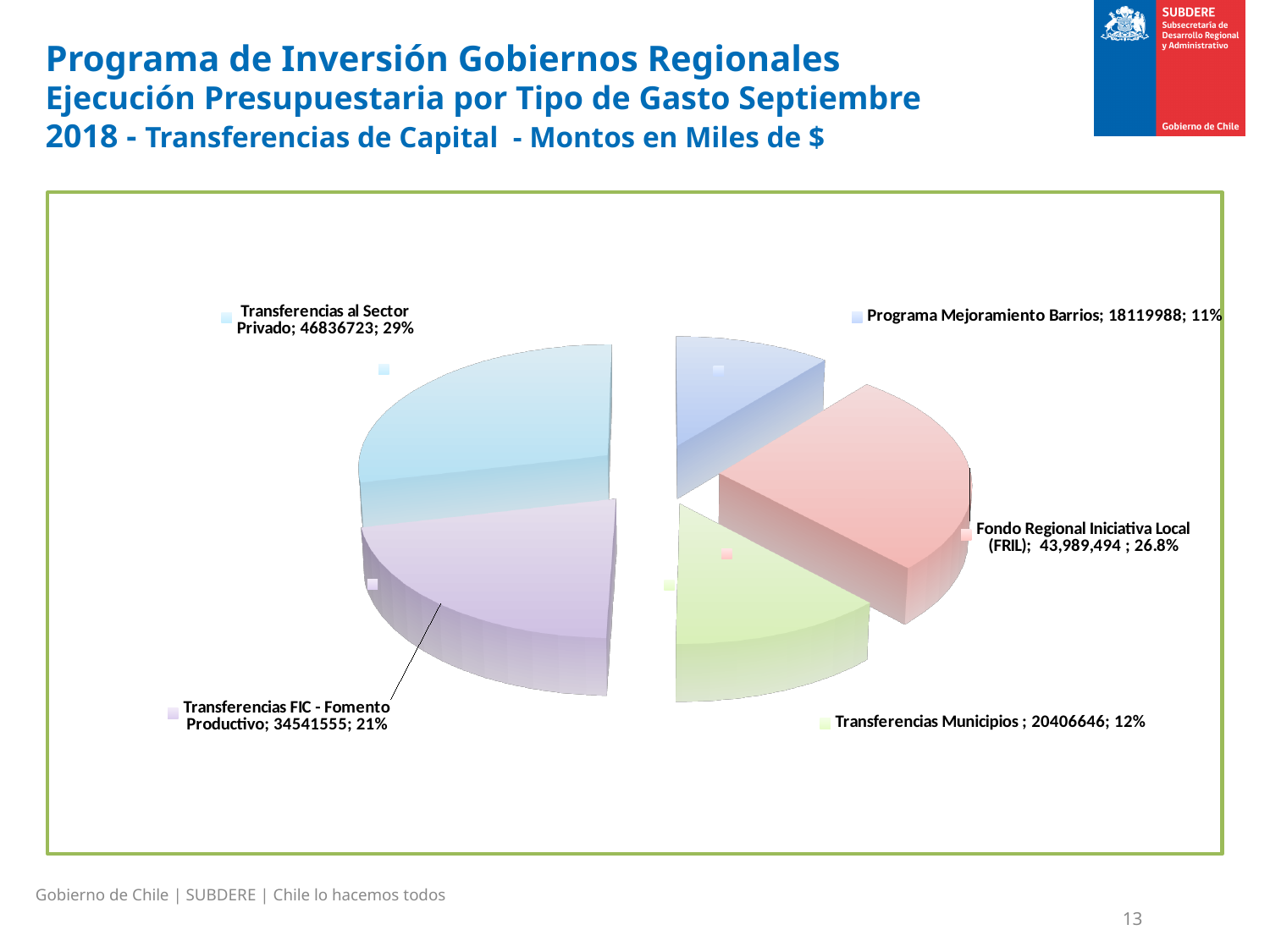
What share of the pie does Transferencias FIC - Fomento Productivo represent? 21% What is the difference between the values for Transferencias al Sector Privado and Fondo Regional Iniciativa Local (FRIL)? 2847229 What is the value for Transferencias Municipios? 20406646 How many slices does the pie chart have? 5 Which category has the lowest value? Programa Mejoramiento Barrios What is the value for Transferencias al Sector Privado? 46836723 What is the value for Fondo Regional Iniciativa Local (FRIL)? 43,989,494 Which is larger, Transferencias Municipios or Programa Mejoramiento Barrios? Transferencias Municipios What share of the pie does Fondo Regional Iniciativa Local (FRIL) represent? 26.8% What is the value for Programa Mejoramiento Barrios? 18119988 What kind of chart is shown on the slide? Pie chart Which category has the highest value? Transferencias al Sector Privado